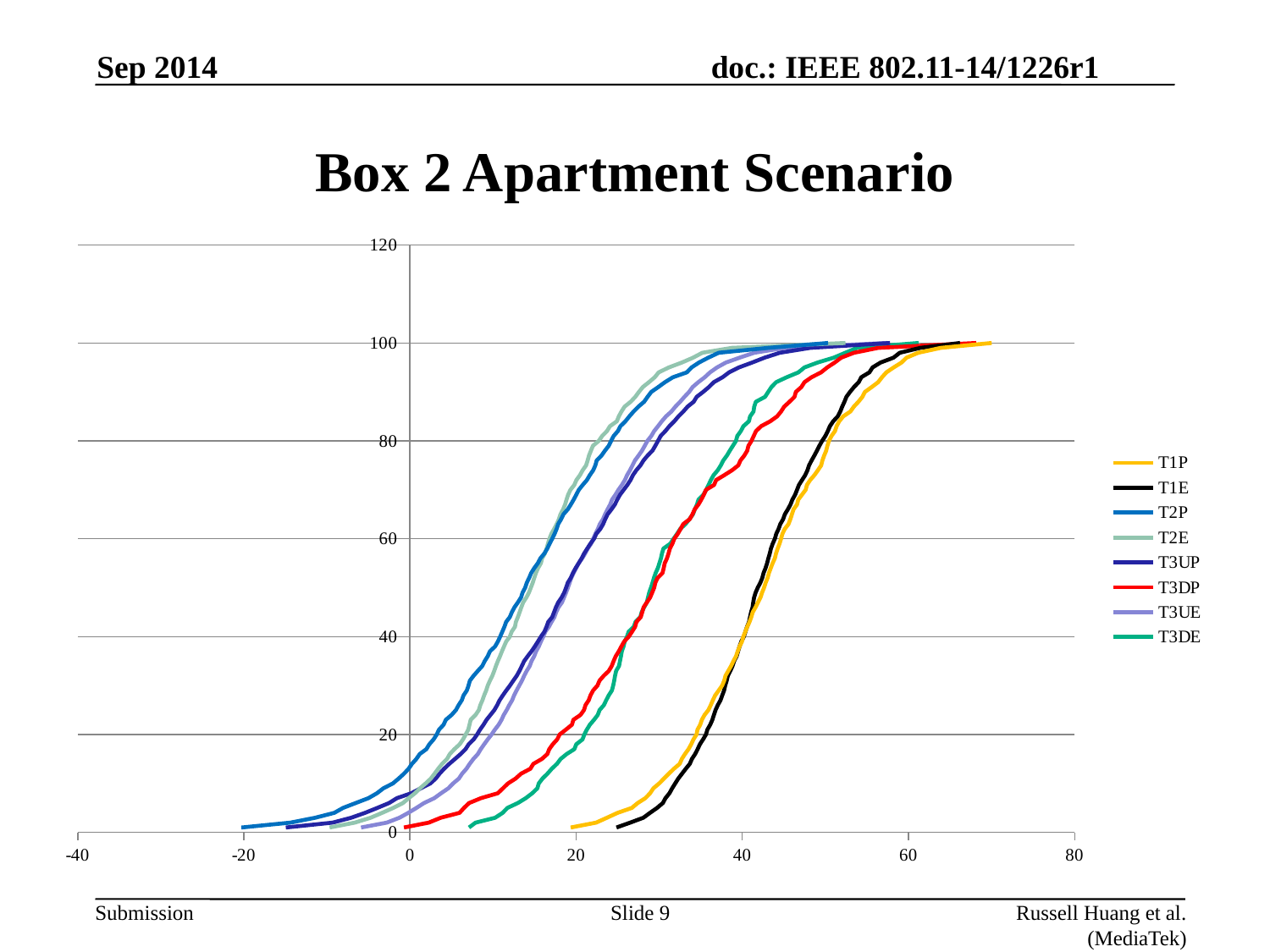
At x = 40, is the value for T3DE greater or less than 60? greater At x = 60, is the value for T1E greater or less than 80? greater How many series does the legend list? 8 What is the title of the chart? Box 2 Apartment Scenario Which series is drawn in red? T3DP At x = 0, is the value for T2P greater or less than 20? less Do the values of the series rise or fall as x increases? rise What kind of chart is shown on the slide? line chart At x = 40, which series has the larger value, T3DE or T1E? T3DE At x = 20, which series has the larger value, T2P or T1P? T2P